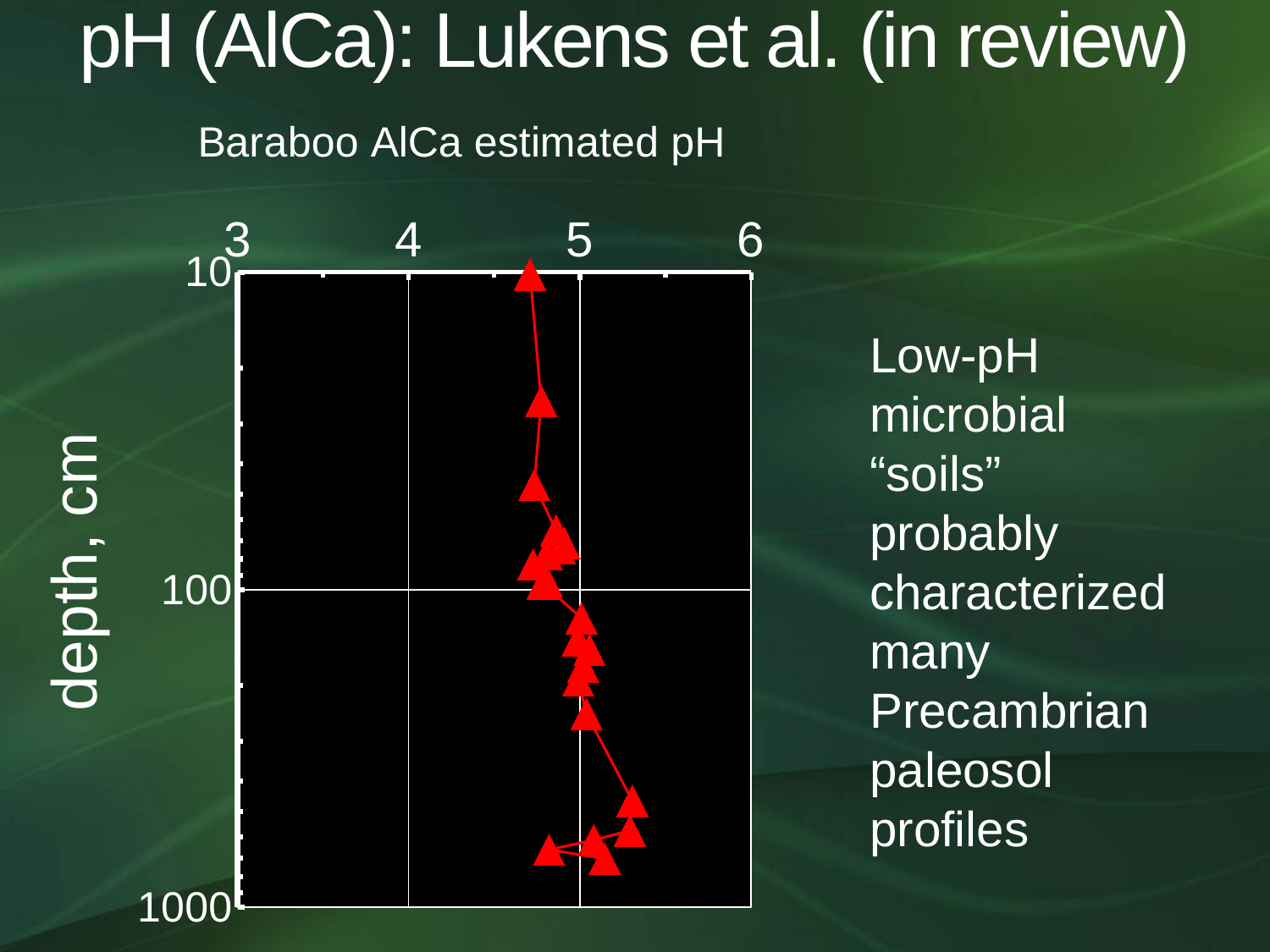
Is the estimated pH at the shallowest depth (10 cm) greater or less than 4? greater Does the estimated pH generally increase or decrease as depth increases from 10 cm to 1000 cm? increase What is the title of the chart? Baraboo AlCa estimated pH What is the lowest depth value labelled on the vertical axis? 10 Are all plotted pH values greater or less than 3? greater What kind of chart is shown on the slide? line chart with triangle markers Is the estimated pH of the deepest plotted points (near 1000 cm) greater or less than 4? greater Which is larger: the estimated pH at 10 cm depth or the estimated pH at the points near 500 cm depth? the points near 500 cm depth How many data series are plotted on the chart? 1 What is the label of the vertical axis of the chart? depth, cm